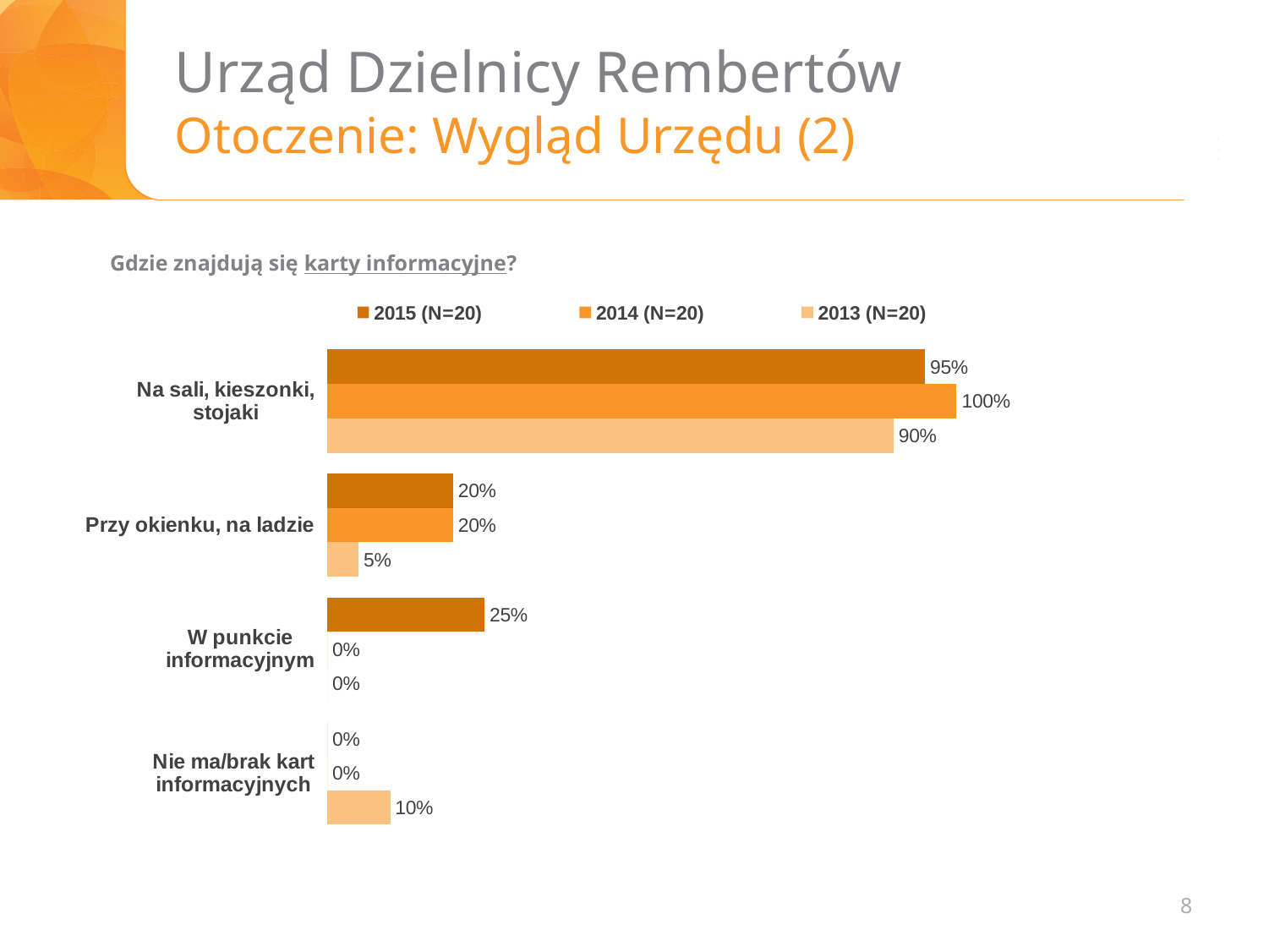
Which category has the lowest value in the 2013 (N=20) series? W punkcie informacyjnym What question does the chart answer, as stated above it? Gdzie znajdują się karty informacyjne? How many series does the legend list? 3 What is the value for "W punkcie informacyjnym" in the 2015 (N=20) series? 25% Which is larger for "Przy okienku, na ladzie": the 2015 (N=20) value or the 2013 (N=20) value? 2015 (N=20) How many categories are shown on the chart? 4 What is the difference between the 2014 (N=20) and 2013 (N=20) values for "Na sali, kieszonki, stojaki"? 10% What kind of chart is shown on the slide? Bar chart Which category has the highest value in the 2014 (N=20) series? Na sali, kieszonki, stojaki What is the value for "Nie ma/brak kart informacyjnych" in the 2013 (N=20) series? 10% What is the value for "Przy okienku, na ladzie" in the 2013 (N=20) series? 5% What is the value for "Na sali, kieszonki, stojaki" in the 2015 (N=20) series? 95%